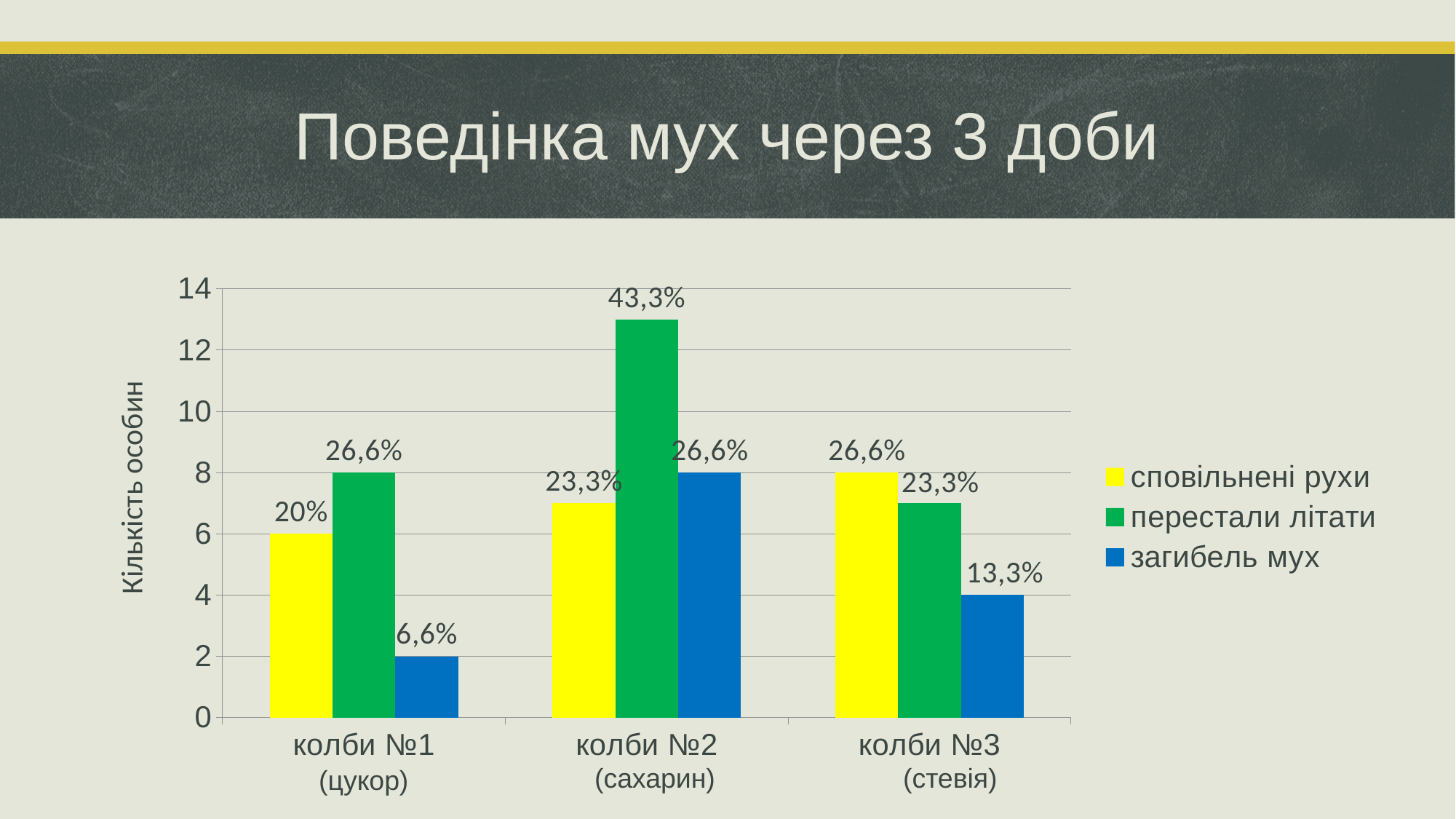
What is the data label for "загибель мух" in "колби №1 (цукор)"? 6,6% Which is larger: "загибель мух" in "колби №2 (сахарин)" or "загибель мух" in "колби №3 (стевія)"? колби №2 (сахарин) What is the data label for "загибель мух" in "колби №3 (стевія)"? 13,3% How many categories are shown on the x axis? 3 What kind of chart is shown on the slide? bar chart What is the data label for "сповільнені рухи" in "колби №3 (стевія)"? 26,6% How many series does the legend list? 3 Is the value for "перестали літати" in "колби №2 (сахарин)" greater or less than 12? greater Which category has the lowest bar for "загибель мух"? колби №1 (цукор) What is the label of the y axis? Кількість особин What is the data label for "перестали літати" in "колби №2 (сахарин)"? 43,3% Which category has the highest bar for "перестали літати"? колби №2 (сахарин)